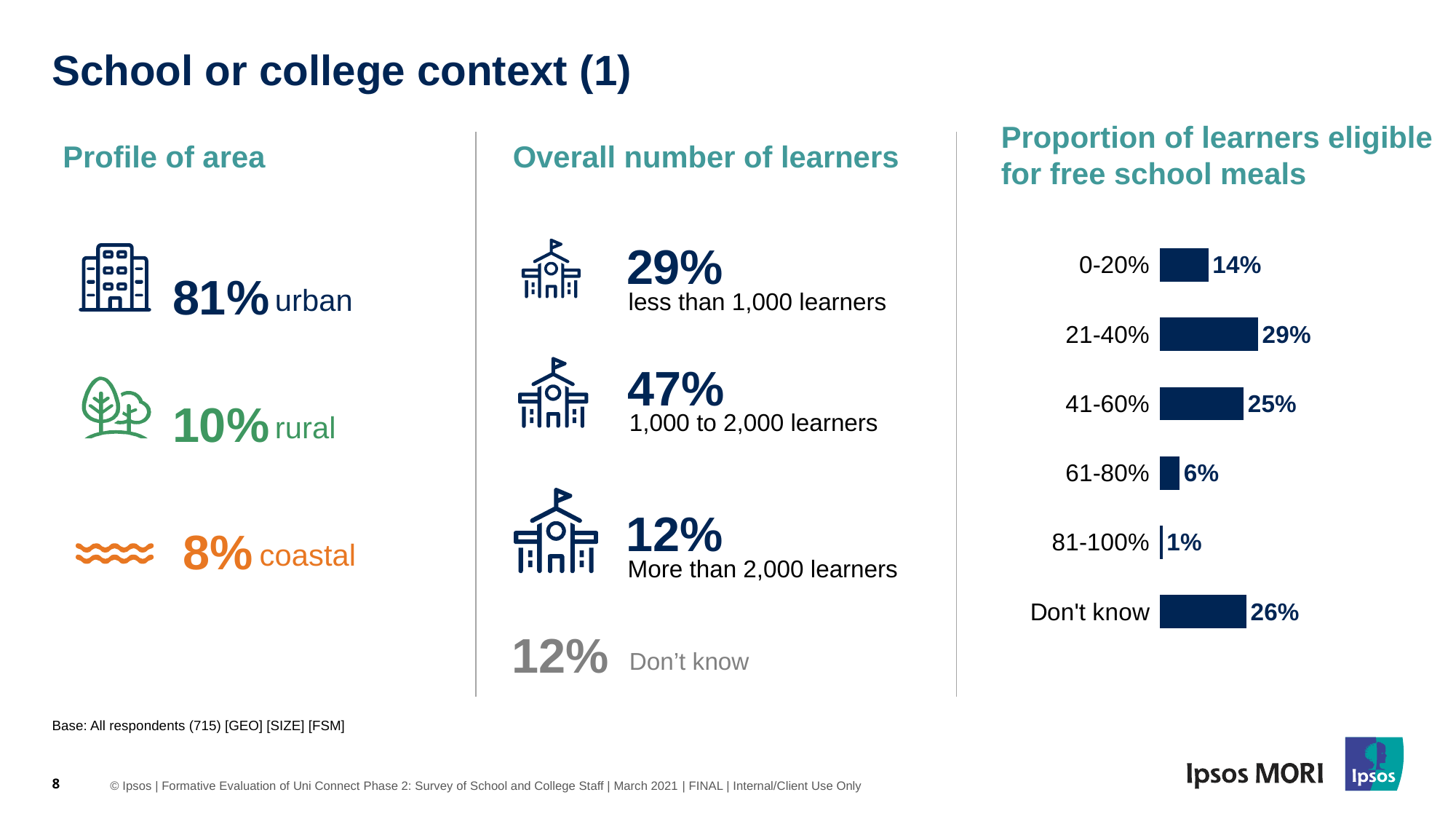
In the 'Proportion of learners eligible for free school meals' chart, what is the value for 41-60%? 25% In the 'Proportion of learners eligible for free school meals' chart, which category has the lowest value? 81-100% How many categories are shown in the 'Proportion of learners eligible for free school meals' chart? 6 In the 'Proportion of learners eligible for free school meals' chart, what is the value for 61-80%? 6% In the 'Proportion of learners eligible for free school meals' chart, what is the difference between the values for 21-40% and 0-20%? 15% In the 'Proportion of learners eligible for free school meals' chart, what is the value for 21-40%? 29% In the 'Proportion of learners eligible for free school meals' chart, what is the difference between the values for Don't know and 61-80%? 20% In the 'Proportion of learners eligible for free school meals' chart, what is the value for 0-20%? 14% What type of chart is the 'Proportion of learners eligible for free school meals' chart? Bar chart In the 'Proportion of learners eligible for free school meals' chart, what is the value for Don't know? 26% In the 'Proportion of learners eligible for free school meals' chart, which is larger: the value for 41-60% or the value for Don't know? Don't know In the 'Proportion of learners eligible for free school meals' chart, which category has the highest value? 21-40%